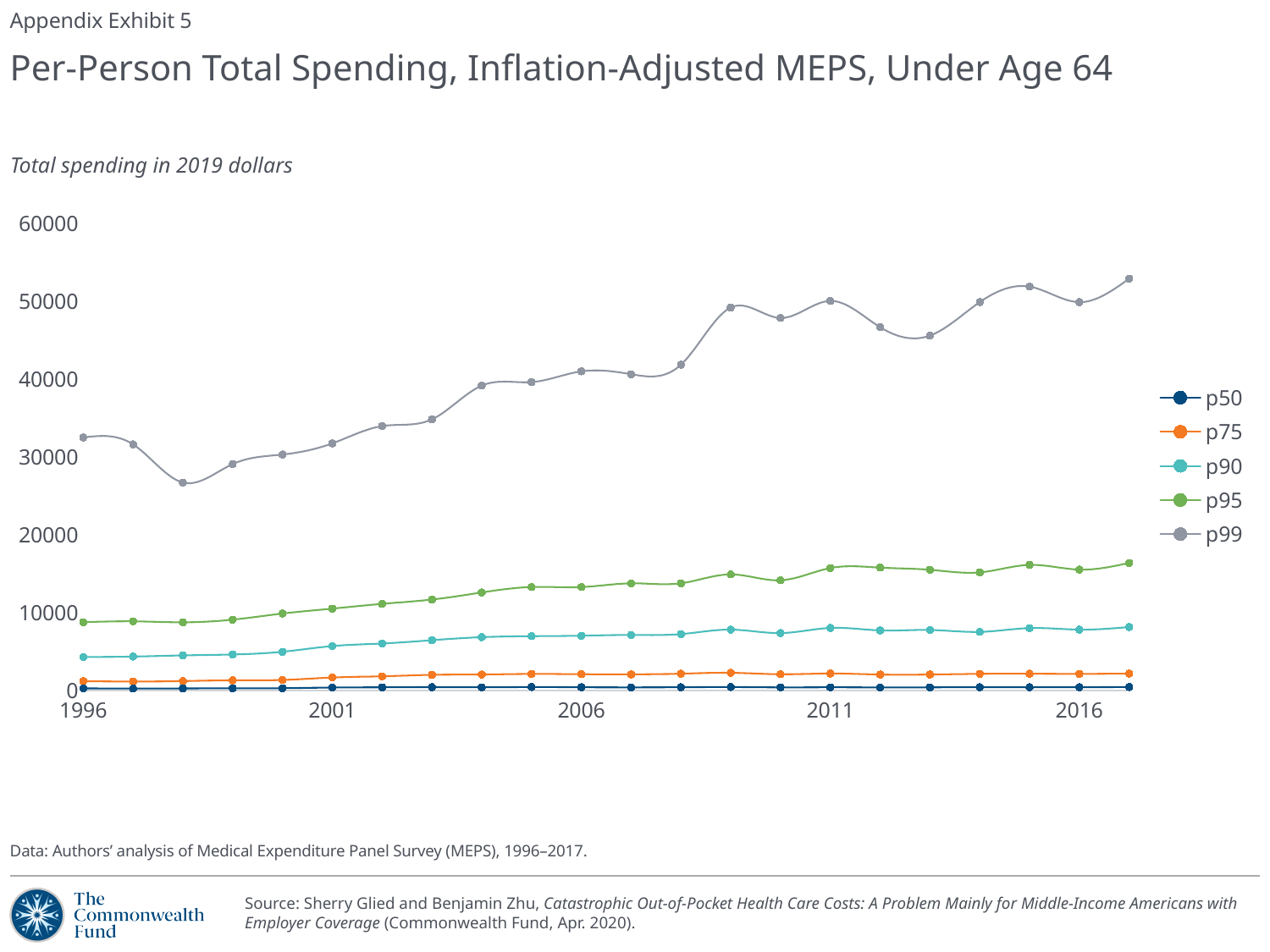
Does the p99 series generally rise or fall from 1996 to 2017? Rise Is the value for p90 in 2017 greater or less than 10000? less What is the title of the chart? Per-Person Total Spending, Inflation-Adjusted MEPS, Under Age 64 How many series does the legend list? 5 Is the value for p95 in 1996 greater or less than 10000? less Is the value for p99 in 1998 greater or less than 30000? less Which series has the highest values throughout the chart? p99 Which is larger for p99: the value in 1996 or the value in 2017? 2017 What kind of chart is shown on the slide? Line chart Which series has the lowest values throughout the chart? p50